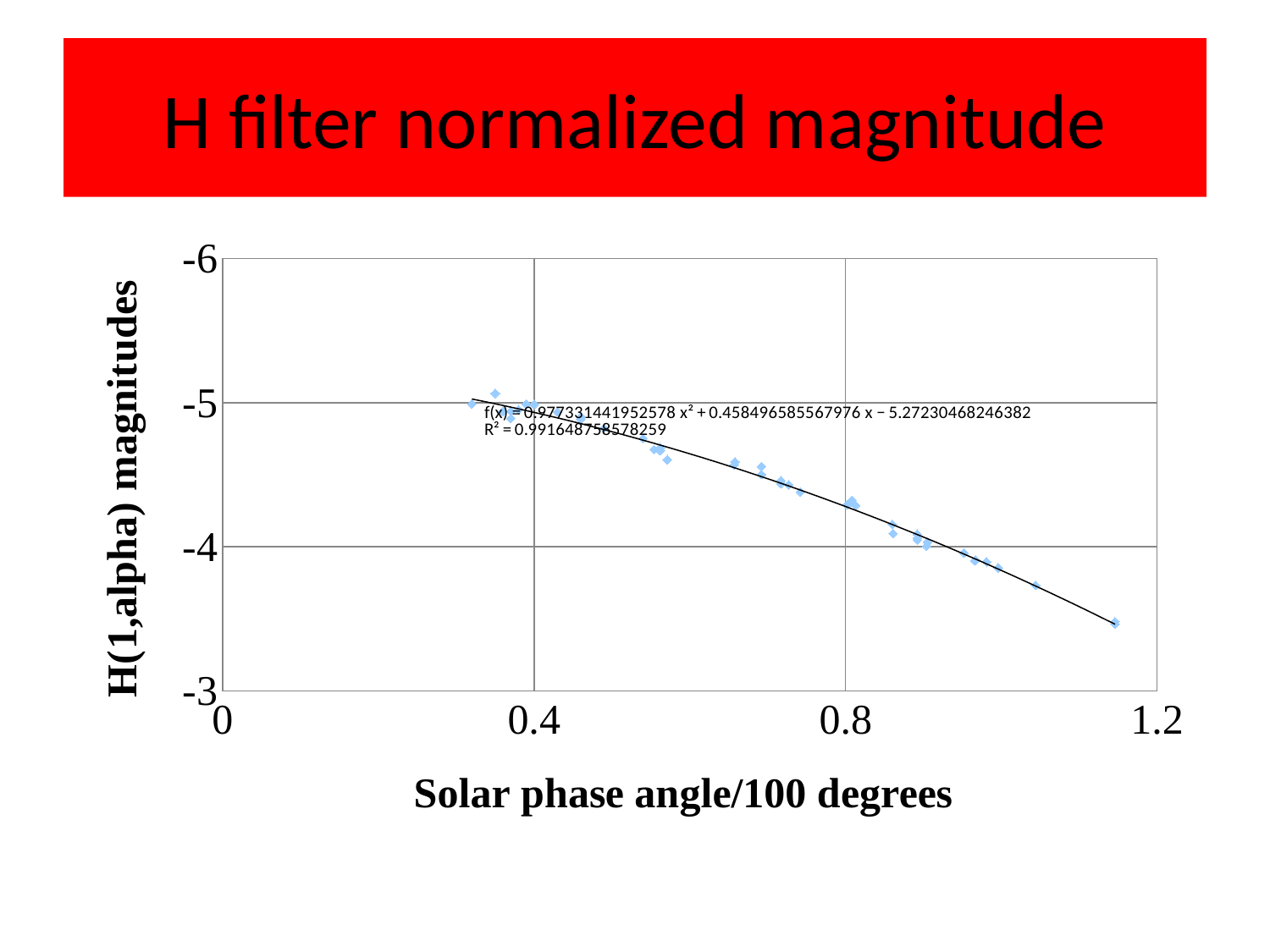
What is the title of the slide/chart? H filter normalized magnitude What is the coefficient of x in the fitted equation f(x) printed on the chart? 0.458496585567976 What is the largest value shown on the x axis? 1.2 What is the constant term in the fitted equation f(x) printed on the chart? −5.27230468246382 What kind of chart is shown on the slide? scatter chart Is the H(1,alpha) magnitude of the rightmost data point (near x = 1.15) greater or less than -4? greater What is the label of the x axis? Solar phase angle/100 degrees What R² value is printed on the chart for the fitted curve? 0.991648758578259 What is the coefficient of x² in the fitted equation f(x) printed on the chart? 0.977331441952578 As the solar phase angle increases along the x axis, do the H(1,alpha) magnitude values move toward -3 or toward -6? toward -3 Is the H(1,alpha) magnitude of the data points near x = 0.7 greater or less than -4? less How many data series are plotted on the chart? 1